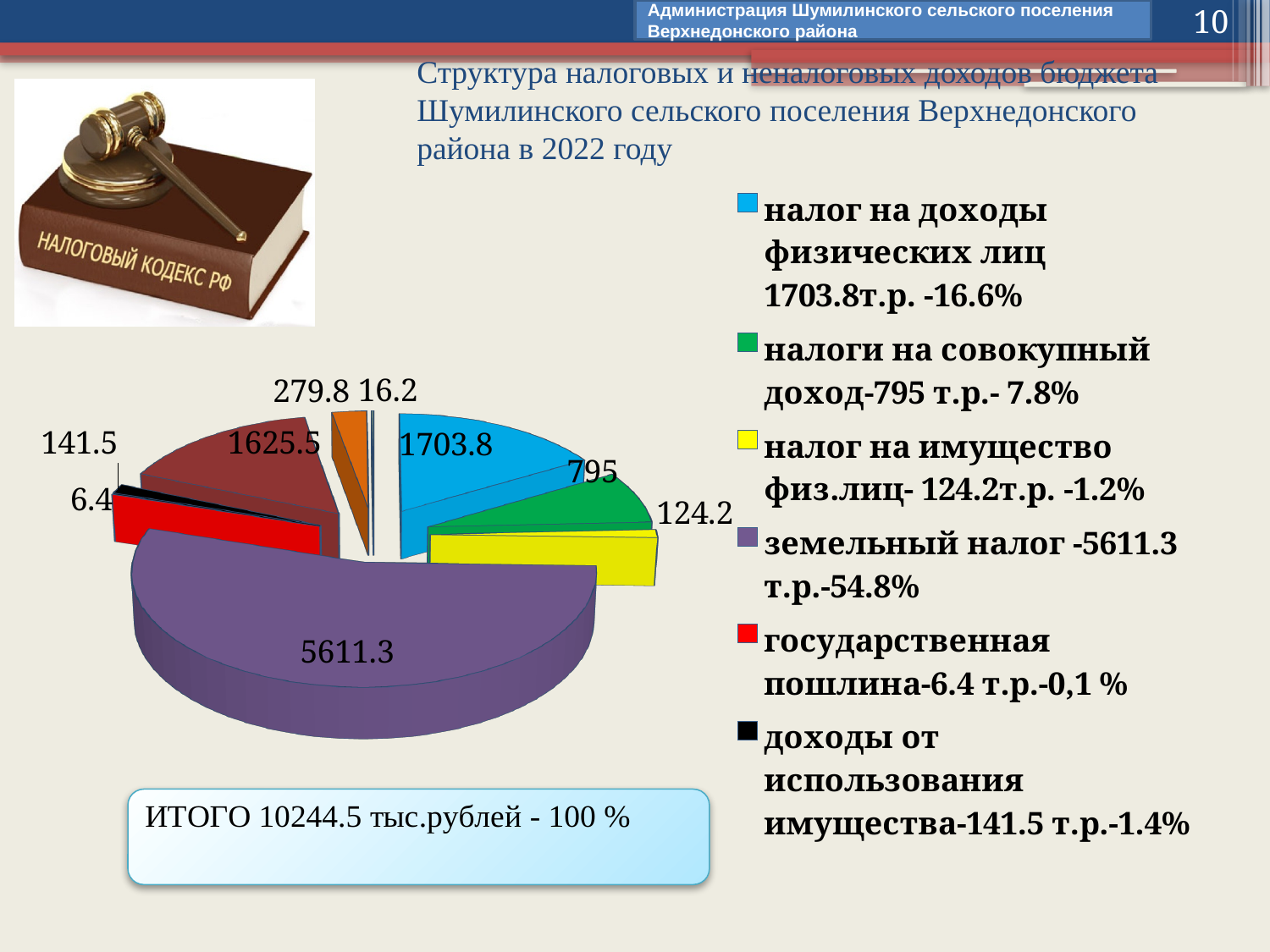
What value is labelled on the slice for земельный налог? 5611.3 What is the difference between the slice labelled 1703.8 and the slice labelled 795? 908.8 What is the smallest value labelled on the pie chart? 6.4 Which category has the largest slice of the pie? земельный налог What type of chart is shown on the slide? Pie chart What total (ИТОГО) is stated for the pie chart? 10244.5 тыс.рублей What value is labelled on the slice for налог на доходы физических лиц? 1703.8 What value is labelled on the slice for налоги на совокупный доход? 795 Which slice is larger: the one labelled 1625.5 or the one labelled 1703.8? 1703.8 What share of the total does налог на доходы физических лиц represent, according to the legend? 16.6% How many slices have a value label on the pie chart? 9 What share of the total does земельный налог represent, according to the legend? 54.8%